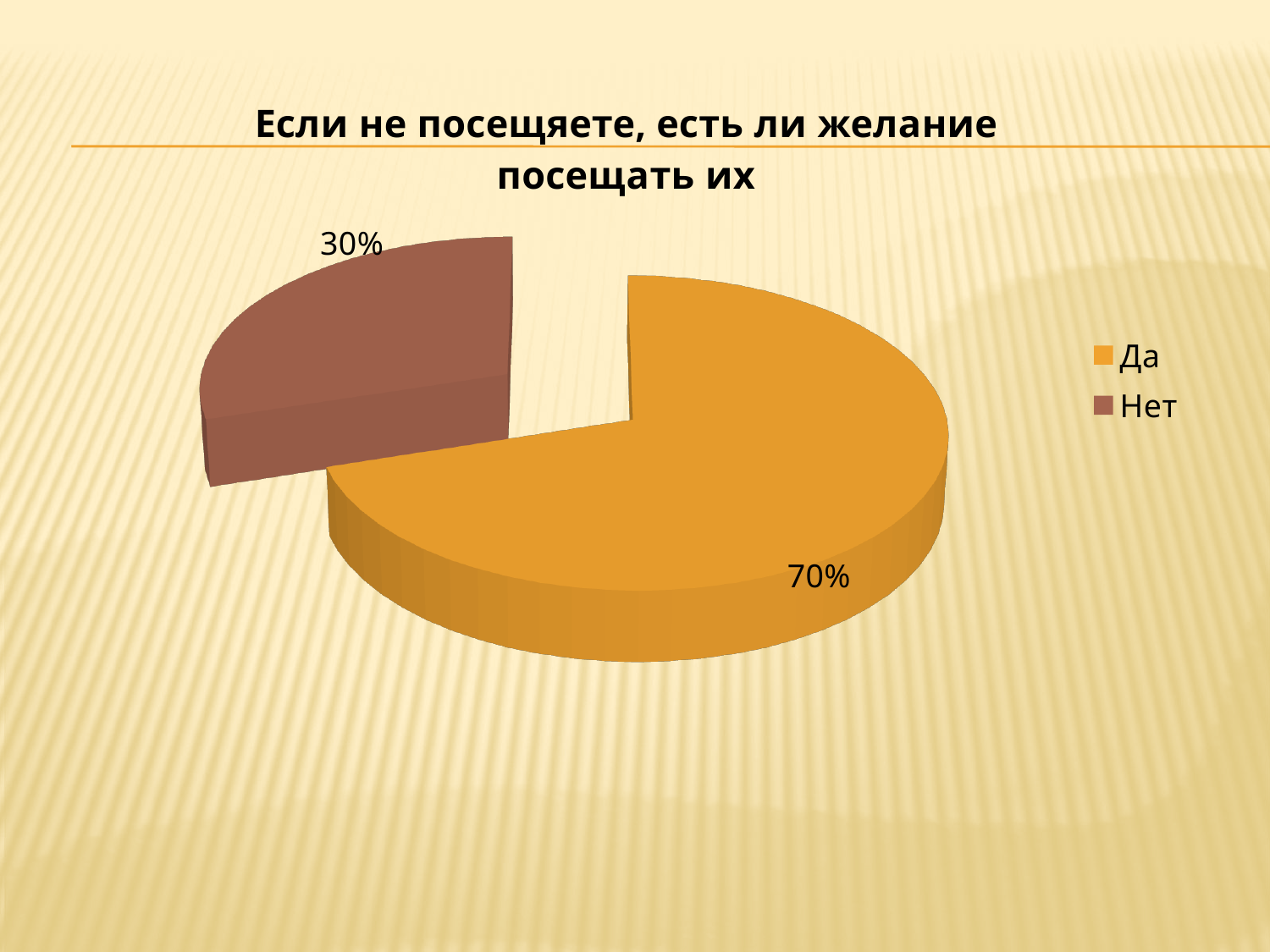
What is the difference between the shares for "Да" and "Нет"? 40% What colour is the slice for "Нет"? Brown How many slices does the pie chart have? 2 Which category has the smallest share of the pie? Нет What share of the pie does "Да" represent? 70% How many entries does the legend list? 2 What type of chart is shown on the slide? Pie chart What is the value for "Да"? 70% What is the title of the chart? Если не посещяете, есть ли желание посещать их Which category has the largest share of the pie? Да What is the value for "Нет"? 30% Which is larger, the share for "Да" or the share for "Нет"? Да